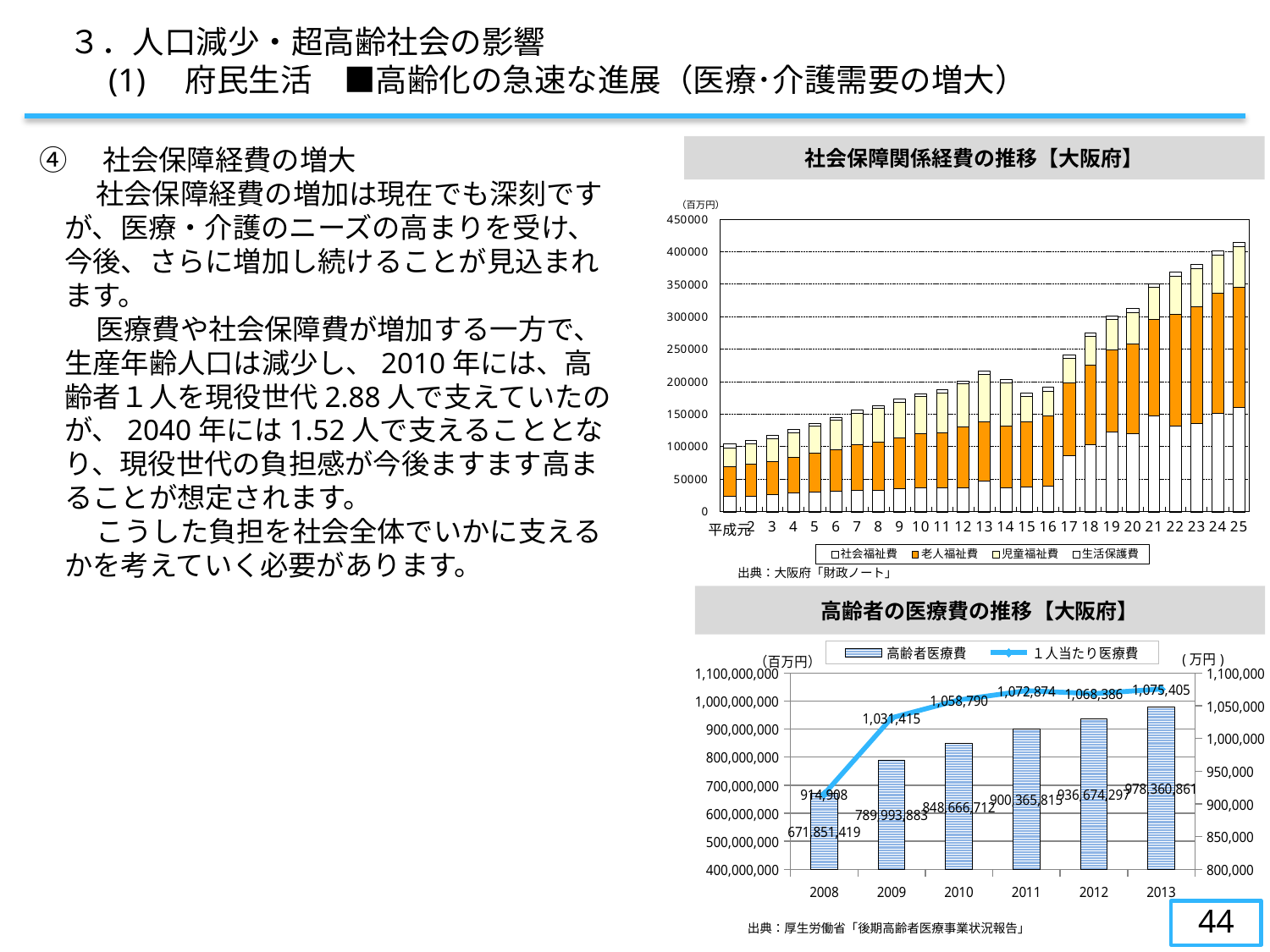
In the bottom chart (高齢者の医療費の推移【大阪府】), which year has the highest 1人当たり医療費? 2013 In the bottom chart (高齢者の医療費の推移【大阪府】), how many years are shown on the x axis? 6 In the bottom chart (高齢者の医療費の推移【大阪府】), what is the value of 高齢者医療費 for 2010? 848,666,712 What kind of chart is the top chart (社会保障関係経費の推移【大阪府】)? Stacked bar chart In the top chart (社会保障関係経費の推移【大阪府】), is the total for 平成25 greater or less than 400000? greater In the bottom chart (高齢者の医療費の推移【大阪府】), how many series does the legend list? 2 In the bottom chart (高齢者の医療費の推移【大阪府】), what is the value of 1人当たり医療費 for 2009? 1,031,415 In the bottom chart (高齢者の医療費の推移【大阪府】), what is the value of 高齢者医療費 for 2013? 978,360,861 In the top chart (社会保障関係経費の推移【大阪府】), how many series does the legend list? 4 In the bottom chart (高齢者の医療費の推移【大阪府】), which year has the lowest 高齢者医療費? 2008 In the bottom chart (高齢者の医療費の推移【大阪府】), which is larger, the 1人当たり医療費 for 2011 or for 2012? 2011 In the bottom chart (高齢者の医療費の推移【大阪府】), what is the difference in 高齢者医療費 between 2013 and 2008? 306,509,442